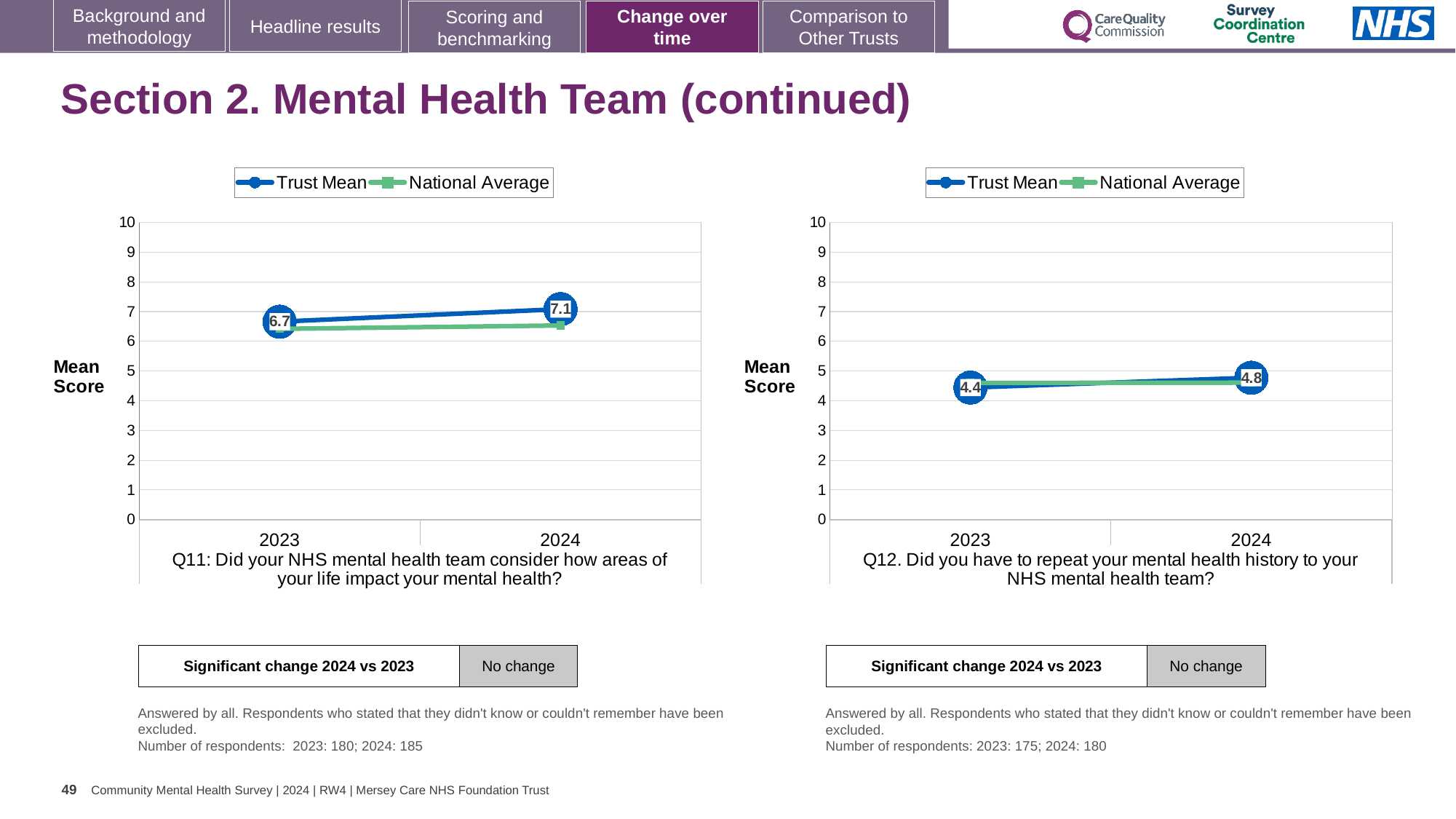
On the Q12 chart (right), what is the Trust Mean score for 2023? 4.4 On the Q11 chart (left), what is the Trust Mean score for 2023? 6.7 On the Q11 chart (left), what is the Trust Mean score for 2024? 7.1 How many series does the legend of the Q11 chart (left) list? 2 What type of chart is used for Q12 (right)? line chart On the Q11 chart (left), is the National Average for 2024 greater or less than 7? less On the Q11 chart (left), by how much did the Trust Mean change from 2023 to 2024? 0.4 On the Q12 chart (right), is the Trust Mean for 2023 greater or less than 5? less On the Q12 chart (right), what is the Trust Mean score for 2024? 4.8 On the Q12 chart (right), what is the difference between the Trust Mean in 2024 and in 2023? 0.4 On the Q11 chart (left), does the Trust Mean rise or fall from 2023 to 2024? rise How many years are shown on the x axis of the Q12 chart (right)? 2